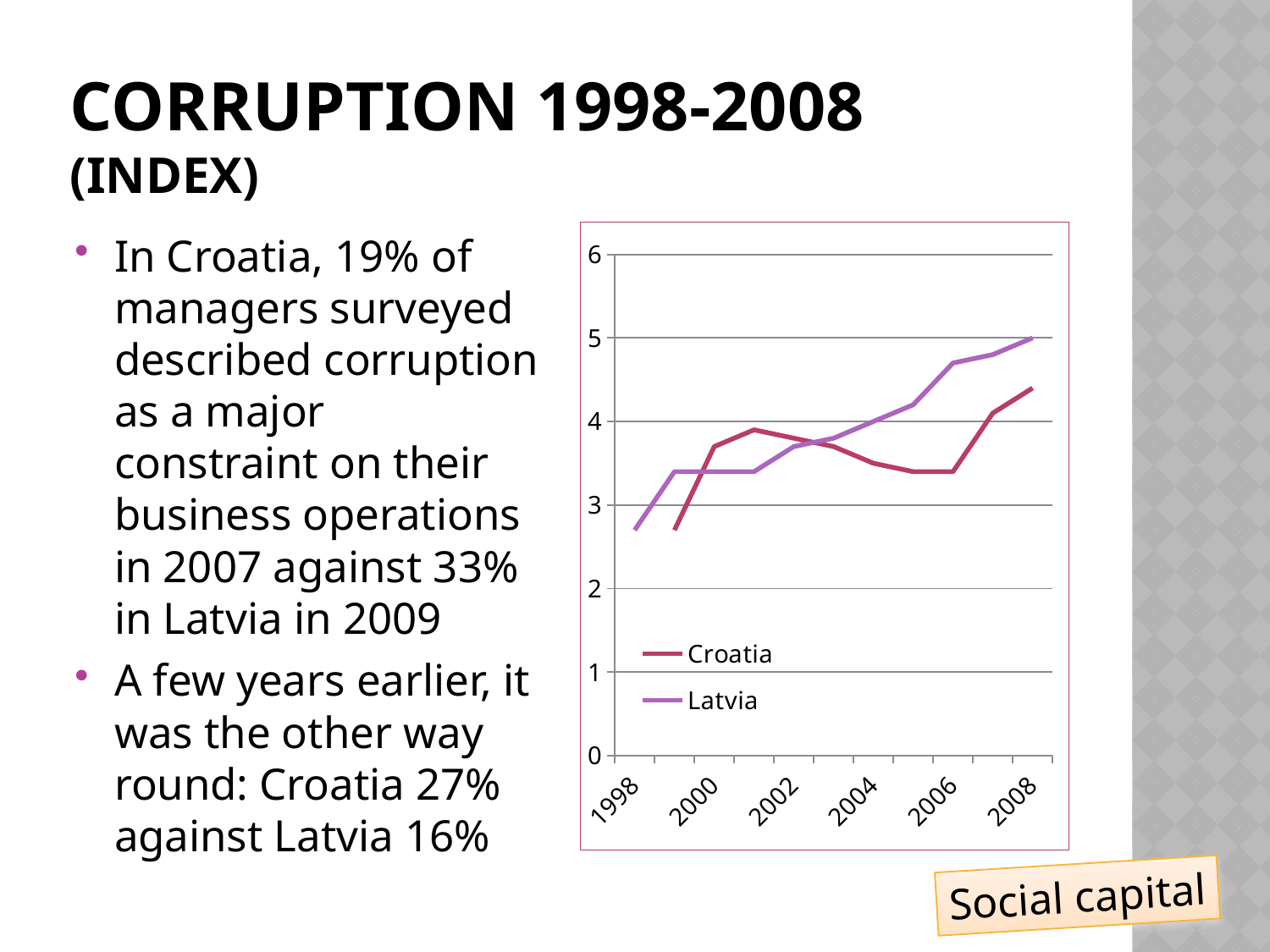
Is the value for Latvia in 2006 greater or less than 4? greater What kind of chart is shown on the slide? line chart What is the title of the slide containing the chart? Corruption 1998-2008 (Index) In 2001, which series has the higher value, Croatia or Latvia? Croatia What is the value for Latvia in 2008? 5 Is the value for Croatia in 2008 greater or less than 4? greater Is the value for Croatia in 2005 greater or less than 4? less Does the Latvia line generally rise or fall from 1998 to 2008? rise In 2008, which series has the higher value, Croatia or Latvia? Latvia How many series does the chart legend list? 2 Which two series are shown in the chart legend? Croatia and Latvia